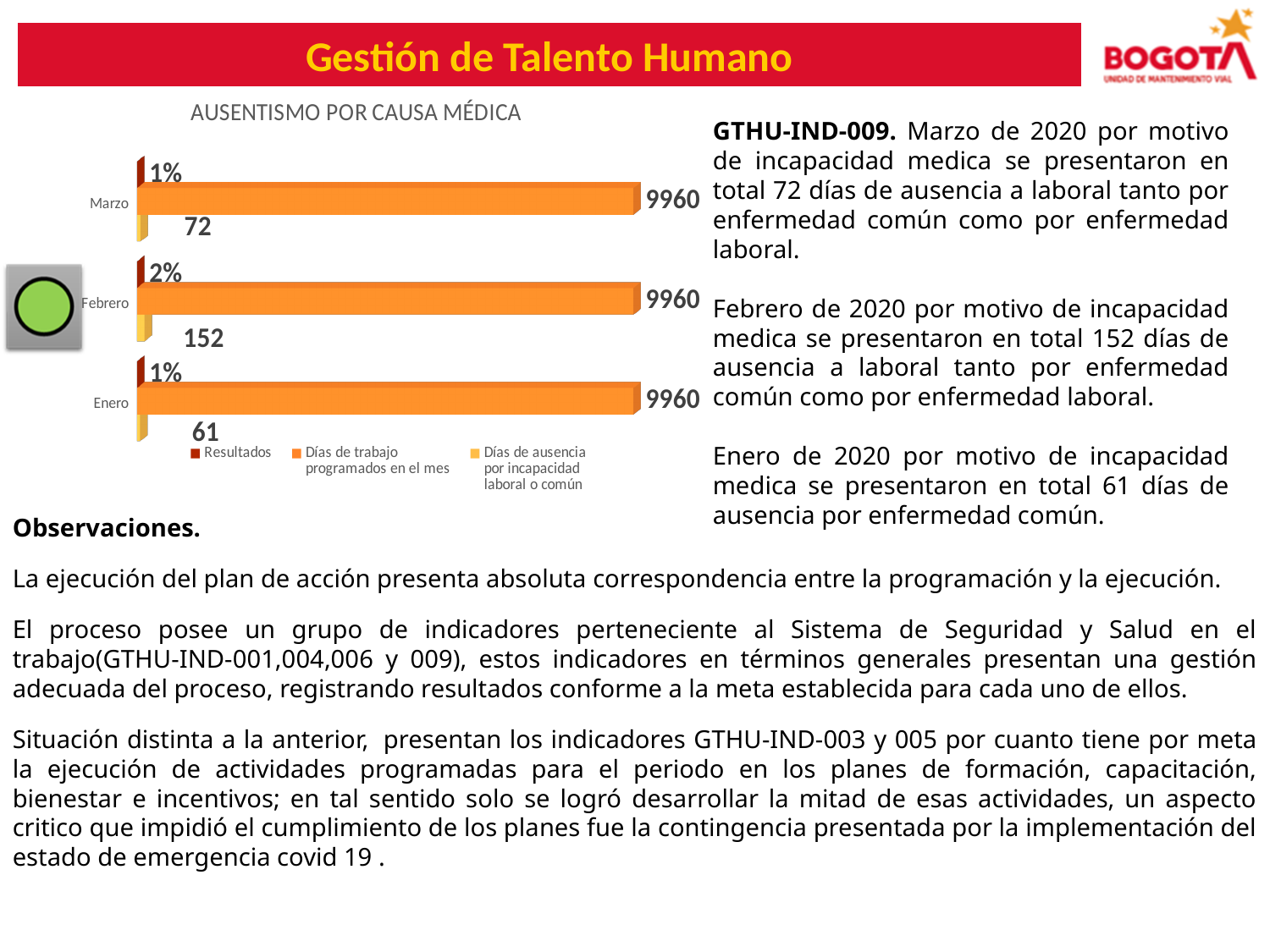
What is the title of the chart? AUSENTISMO POR CAUSA MÉDICA What is the value of 'Días de trabajo programados en el mes' for Marzo? 9960 How many series does the chart legend list? 3 What is the value of 'Días de ausencia por incapacidad laboral o común' for Enero? 61 What kind of chart is shown on the slide? bar chart Which month has the lowest value for 'Días de ausencia por incapacidad laboral o común'? Enero Which month has the highest value for 'Días de ausencia por incapacidad laboral o común'? Febrero What is the value of 'Días de ausencia por incapacidad laboral o común' for Febrero? 152 What is the 'Resultados' value for Febrero? 2% How many months (categories) are shown in the chart? 3 What is the difference between the 'Días de ausencia por incapacidad laboral o común' values for Febrero and Marzo? 80 Which is larger, the 'Días de ausencia por incapacidad laboral o común' value for Marzo or for Enero? Marzo